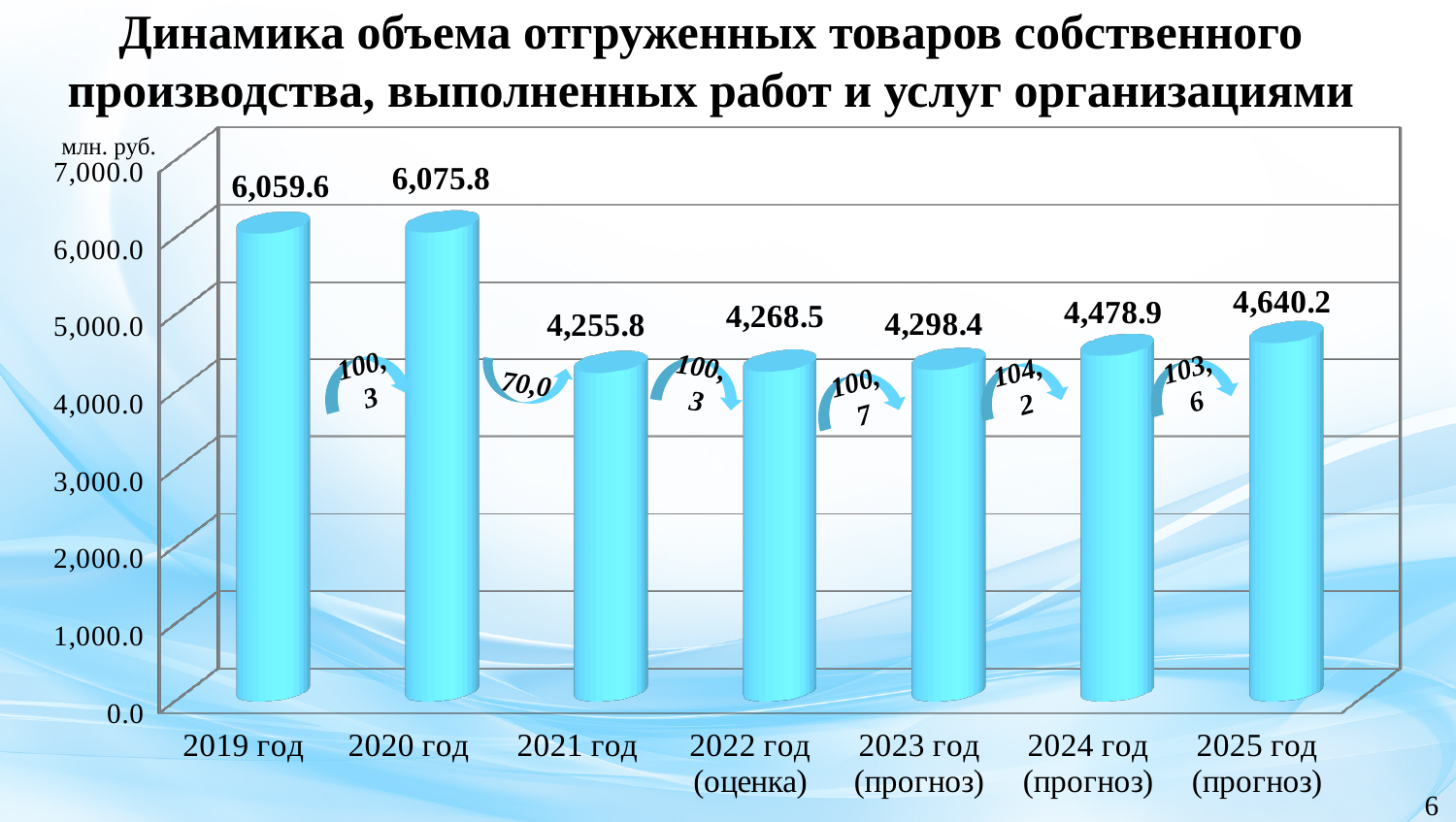
What unit of measurement is indicated on the chart's axis? млн. руб. What is the difference between the values for 2020 год and 2021 год? 1,820.0 What is the value for 2025 год (прогноз)? 4,640.2 What is the value for 2019 год? 6,059.6 What is the difference between the values for 2025 год (прогноз) and 2024 год (прогноз)? 161.3 Which is larger, the value for 2019 год or the value for 2020 год? 2020 год What type of chart is shown on the slide? bar chart How many years (bars) are shown in the chart? 7 Which year has the highest value? 2020 год What is the value for 2022 год (оценка)? 4,268.5 Which year has the lowest value? 2021 год What is the value for 2023 год (прогноз)? 4,298.4